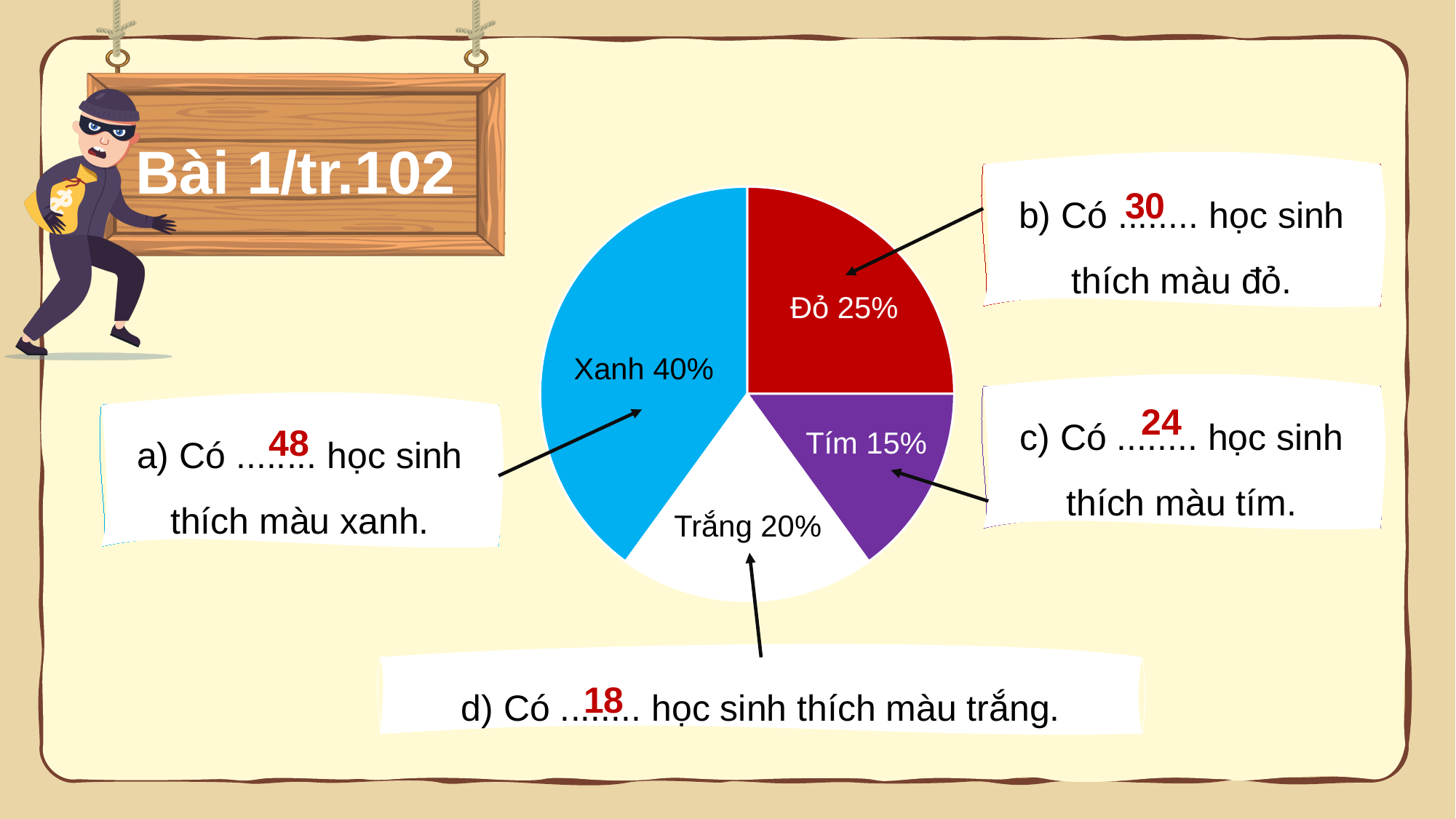
How many slices does the pie chart have? 4 What is the combined share of the Đỏ and Tím slices? 40% Which slice is larger, Trắng or Tím? Trắng What percentage of the pie chart is labelled Xanh? 40% What is the difference in percentage points between the Xanh slice and the Đỏ slice? 15 Which slice of the pie chart is the smallest? Tím What kind of chart is shown on the slide? Pie chart What percentage of the pie chart is labelled Trắng? 20% Which slice of the pie chart is the largest? Xanh What percentage of the pie chart is labelled Tím? 15% What colour is the Tím slice of the pie chart? Purple What percentage of the pie chart is labelled Đỏ? 25%